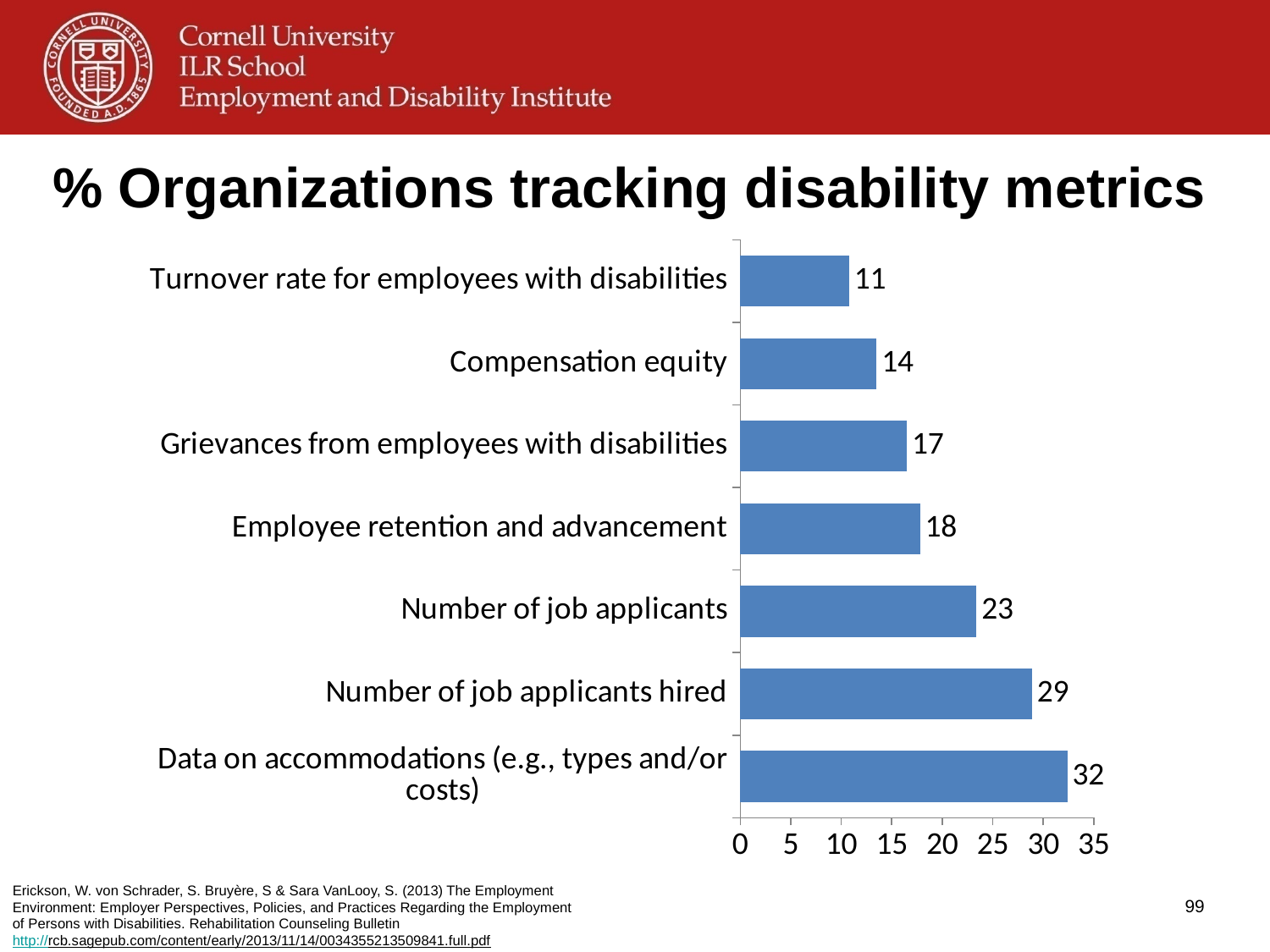
What is the title of the slide? % Organizations tracking disability metrics How many categories are shown in the chart? 7 What is the value for Compensation equity? 14 Which category has the lowest value? Turnover rate for employees with disabilities Is the value for Data on accommodations (e.g., types and/or costs) greater or less than 30? greater What is the value for Number of job applicants hired? 29 What is the maximum value shown on the x axis? 35 Which is larger, the value for Number of job applicants hired or the value for Number of job applicants? Number of job applicants hired What is the value for Grievances from employees with disabilities? 17 What is the difference between the values for Number of job applicants and Employee retention and advancement? 5 What kind of chart is shown on the slide? bar chart Which category has the highest value? Data on accommodations (e.g., types and/or costs)